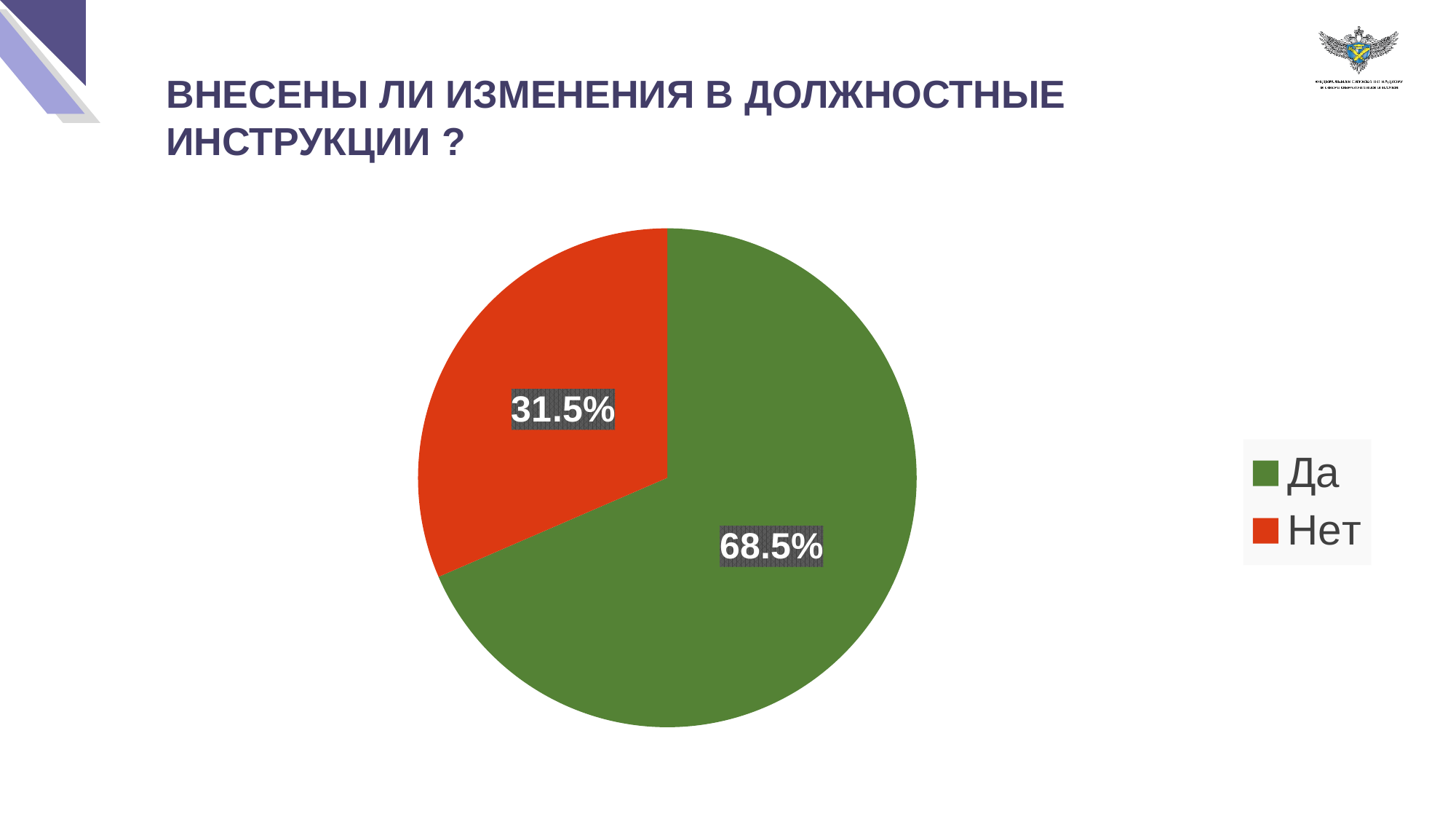
How many slices does the pie chart have? 2 Which is larger, "Да" or "Нет"? Да What is the value for "Нет"? 31.5% What share of the pie does the "Нет" slice take? 31.5% How many entries does the legend list? 2 What is the difference between the "Да" and "Нет" slices? 37% What colour is the "Да" slice? green Which slice is the smallest? Нет What is the value for "Да"? 68.5% Which slice is the largest? Да What colour is the "Нет" slice? red What kind of chart is shown on the slide? pie chart